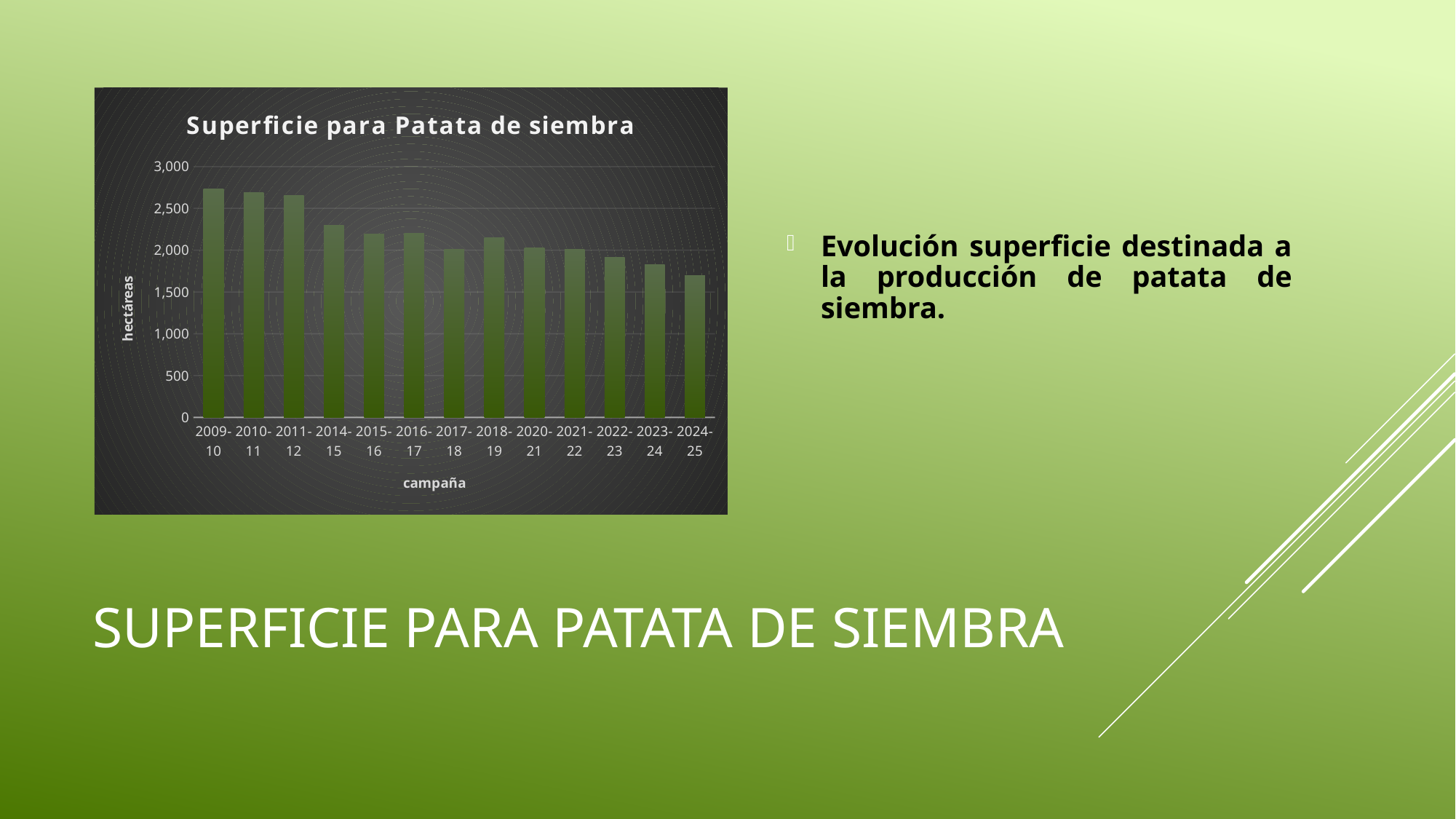
What is the label of the vertical axis of the chart? hectáreas What kind of chart is shown on the slide? bar chart Is the value for 2024-25 greater or less than 2,000? less Which campaign has the lowest value in the chart? 2024-25 Overall, do the values rise or fall from 2009-10 to 2024-25? fall How many campaigns (bars) are shown in the chart? 13 Is the value for 2009-10 greater or less than 2,500? greater Which is larger, the value for 2011-12 or the value for 2014-15? 2011-12 Is the value for 2023-24 greater or less than 1,500? greater What is the title of the chart? Superficie para Patata de siembra Which campaign has the highest value in the chart? 2009-10